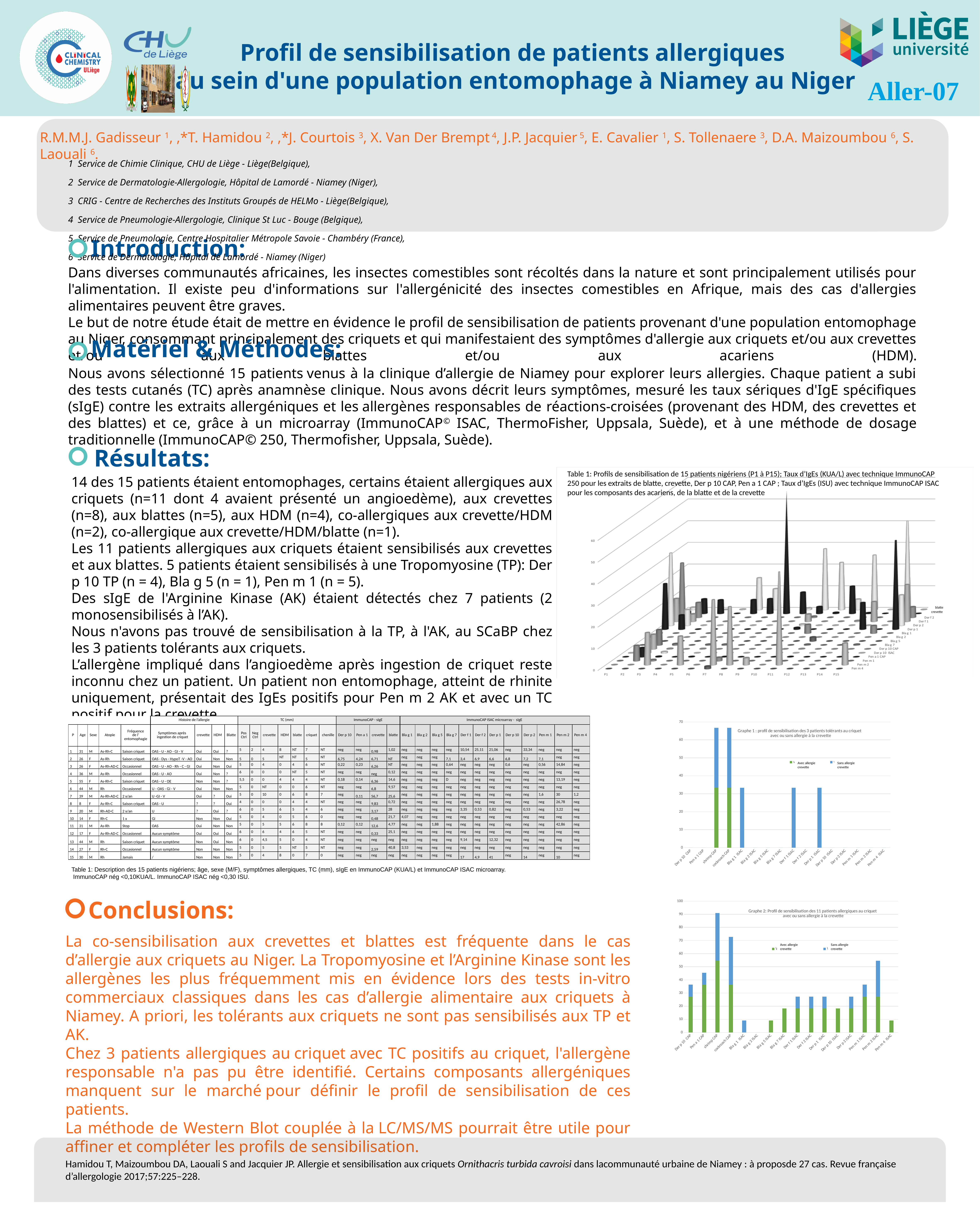
In Graphe 1, is the value for Bla g 1 ISAC greater or less than 20? greater What is the highest tick value on the y axis of Graphe 2? 100 In Graphe 2, is the value for shrimp CAP greater or less than 80? greater How many series does the legend of Graphe 1 list? 2 In Graphe 1, is the value for Pen a 1 CAP greater or less than 60? less In the 3D chart at the top right, how many patients (P1 to P15) are shown along the x axis? 15 In Graphe 2, which is larger, the value for shrimp CAP or the value for Bla g 1 ISAC? shrimp CAP In Graphe 2, which category has the highest bar? shrimp CAP What are the two legend entries in Graphe 2? Avec allergie crevette; Sans allergie crevette What kind of chart is Graphe 2 at the bottom right of the slide? bar chart